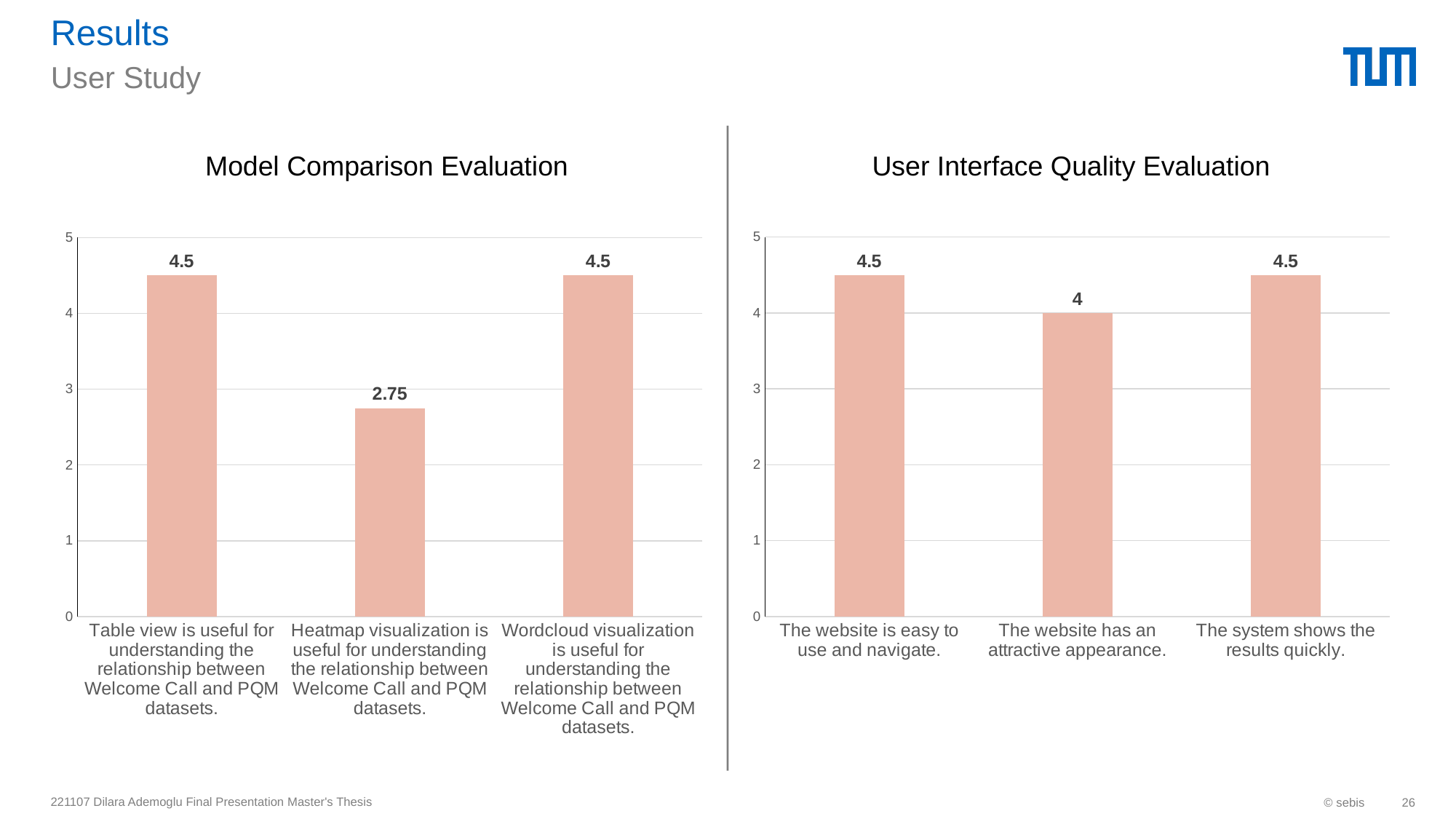
In the Model Comparison Evaluation chart, what is the value for the heatmap visualization statement? 2.75 In the User Interface Quality Evaluation chart, which statement has the lowest value? The website has an attractive appearance. In the User Interface Quality Evaluation chart, what is the difference between the value for 'The website is easy to use and navigate.' and the value for 'The website has an attractive appearance.'? 0.5 In the User Interface Quality Evaluation chart, is the value for 'The website is easy to use and navigate.' larger or smaller than the value for 'The website has an attractive appearance.'? larger In the Model Comparison Evaluation chart, how many bars are plotted? 3 In the Model Comparison Evaluation chart, what is the value for the table view statement? 4.5 In the Model Comparison Evaluation chart, what is the difference between the wordcloud visualization value and the heatmap visualization value? 1.75 What is the title of the chart on the left side of the slide? Model Comparison Evaluation In the User Interface Quality Evaluation chart, what is the value for 'The website has an attractive appearance.'? 4 In the User Interface Quality Evaluation chart, what is the value for 'The system shows the results quickly.'? 4.5 In the Model Comparison Evaluation chart, which statement has the lowest value? Heatmap visualization is useful for understanding the relationship between Welcome Call and PQM datasets. What type of chart is the User Interface Quality Evaluation chart? bar chart